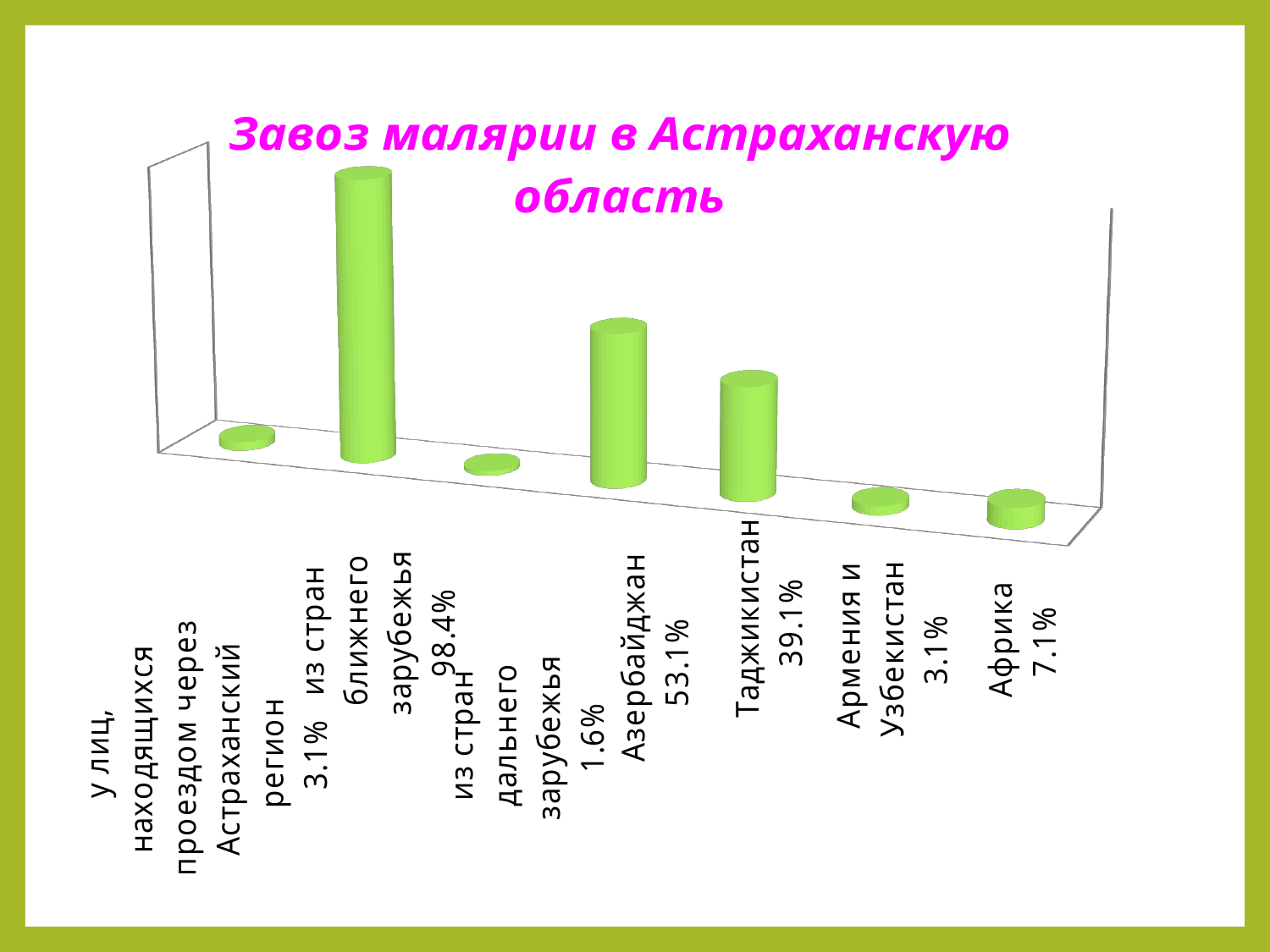
What is the value for «из стран ближнего зарубежья»? 98.4% Which category has the lowest value? из стран дальнего зарубежья What is the value for Таджикистан? 39.1% What is the title of the chart? Завоз малярии в Астраханскую область What is the value for Африка? 7.1% How many categories are shown in the chart? 7 Which is larger, the value for Африка or the value for «Армения и Узбекистан»? Африка What is the value for Азербайджан? 53.1% Which category has the highest value? из стран ближнего зарубежья What kind of chart is shown on the slide? Bar chart What is the difference between the values for Азербайджан and Таджикистан? 14.0% What is the value for «из стран дальнего зарубежья»? 1.6%